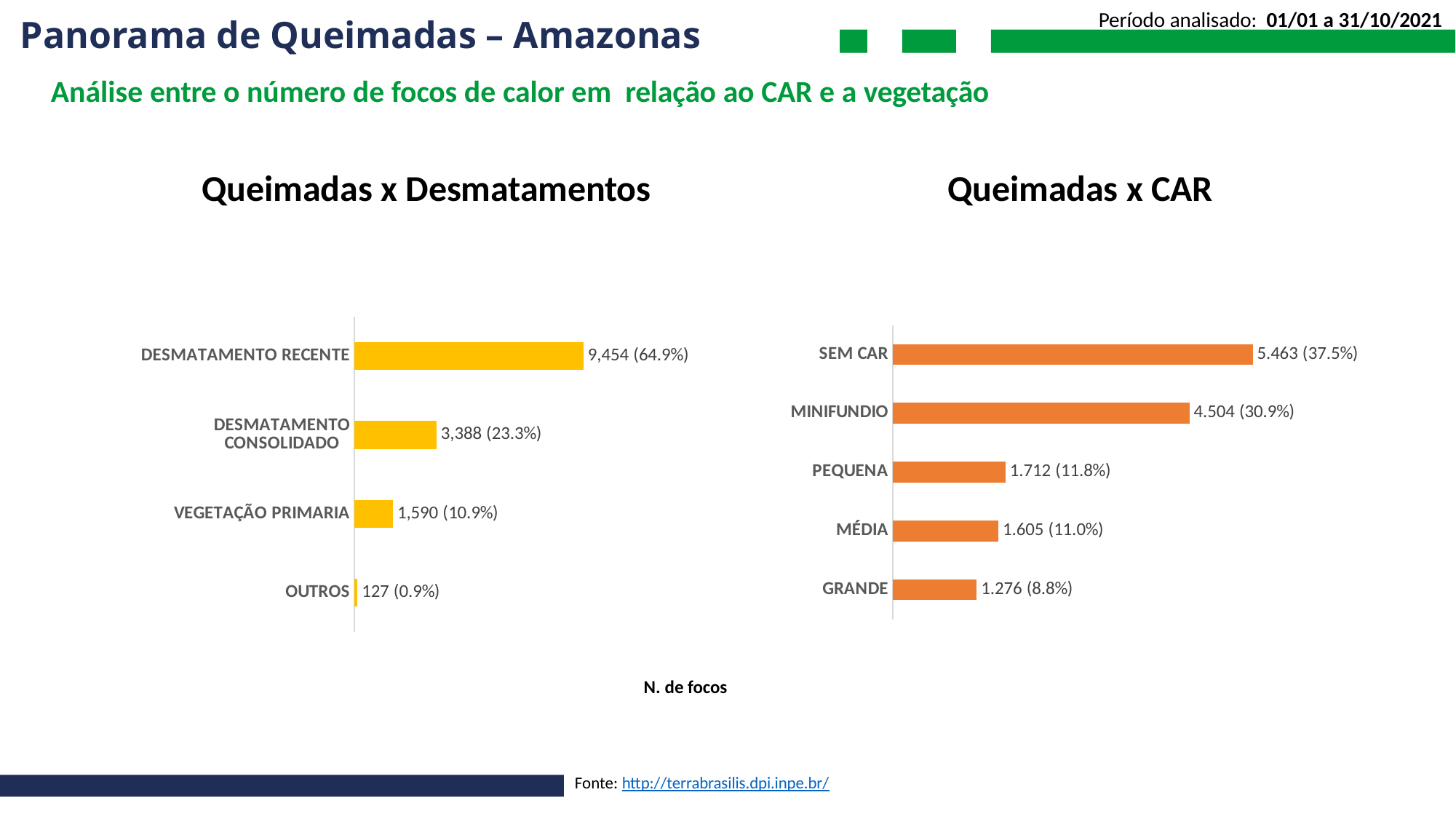
In the 'Queimadas x CAR' chart, what is the difference in focos between SEM CAR and MINIFUNDIO? 959 In the 'Queimadas x Desmatamentos' chart, what is the difference in focos between DESMATAMENTO RECENTE and DESMATAMENTO CONSOLIDADO? 6,066 In the 'Queimadas x CAR' chart, what value is shown for MINIFUNDIO? 4.504 (30.9%) In the 'Queimadas x CAR' chart, which is larger, PEQUENA or GRANDE? PEQUENA In the 'Queimadas x CAR' chart, how many categories are plotted? 5 In the 'Queimadas x Desmatamentos' chart, what value is shown for DESMATAMENTO RECENTE? 9,454 (64.9%) In the 'Queimadas x CAR' chart, what value is shown for GRANDE? 1.276 (8.8%) In the 'Queimadas x CAR' chart, which category has the highest number of focos? SEM CAR In the 'Queimadas x Desmatamentos' chart, what value is shown for VEGETAÇÃO PRIMARIA? 1,590 (10.9%) In the 'Queimadas x Desmatamentos' chart, which category has the lowest number of focos? OUTROS What type of chart is 'Queimadas x CAR'? Bar chart In the 'Queimadas x Desmatamentos' chart, how many categories are plotted? 4